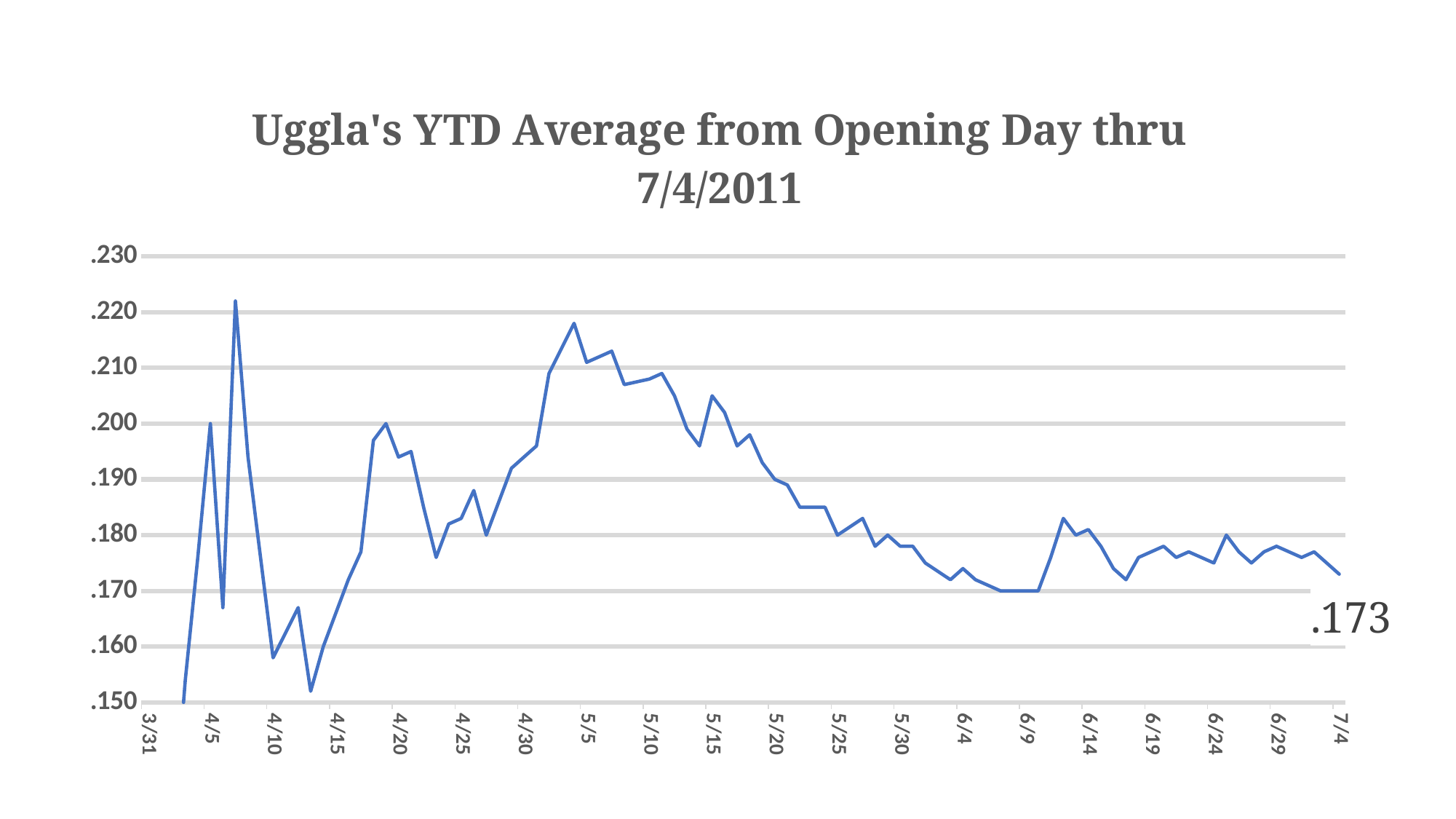
Is the value for 6/4 greater or less than .180? less Is the highest point on the line greater or less than .220? greater What is the title of the chart? Uggla's YTD Average from Opening Day thru 7/4/2011 Which is larger, the value on 4/20 or the value on 4/10? 4/20 Is the value for 5/15 greater or less than .190? greater What is the YTD average shown by the data label at the end of the line on 7/4? .173 What kind of chart is shown on the slide? line chart How many lines (series) are plotted on the chart? 1 Does the line generally rise or fall between 5/5 and 6/9? fall Which is larger, the value on 5/5 or the value on 6/9? 5/5